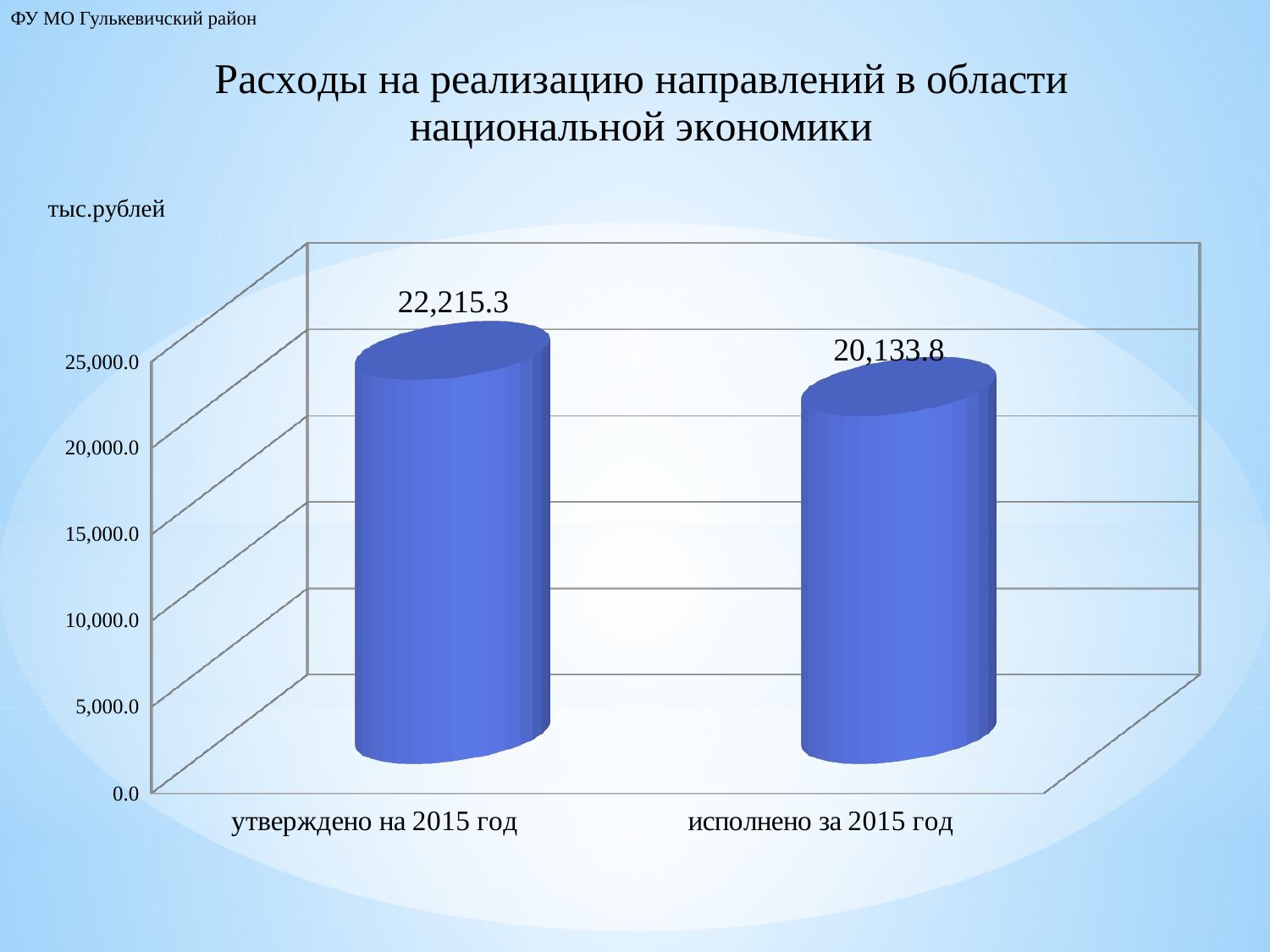
Is the value for "исполнено за 2015 год" greater or less than 20,000.0? greater What is the difference between the value for "утверждено на 2015 год" and the value for "исполнено за 2015 год"? 2,081.5 How many categories are shown on the chart? 2 What is the value for "утверждено на 2015 год"? 22,215.3 Do the values rise or fall from left to right along the x axis? fall Which category has the highest value? утверждено на 2015 год Is the value for "утверждено на 2015 год" greater or less than 25,000.0? less What is the value for "исполнено за 2015 год"? 20,133.8 Which category has the lowest value? исполнено за 2015 год Which is larger: the value for "утверждено на 2015 год" or the value for "исполнено за 2015 год"? утверждено на 2015 год What unit of measurement is indicated above the chart? тыс.рублей What kind of chart is shown on the slide? bar chart